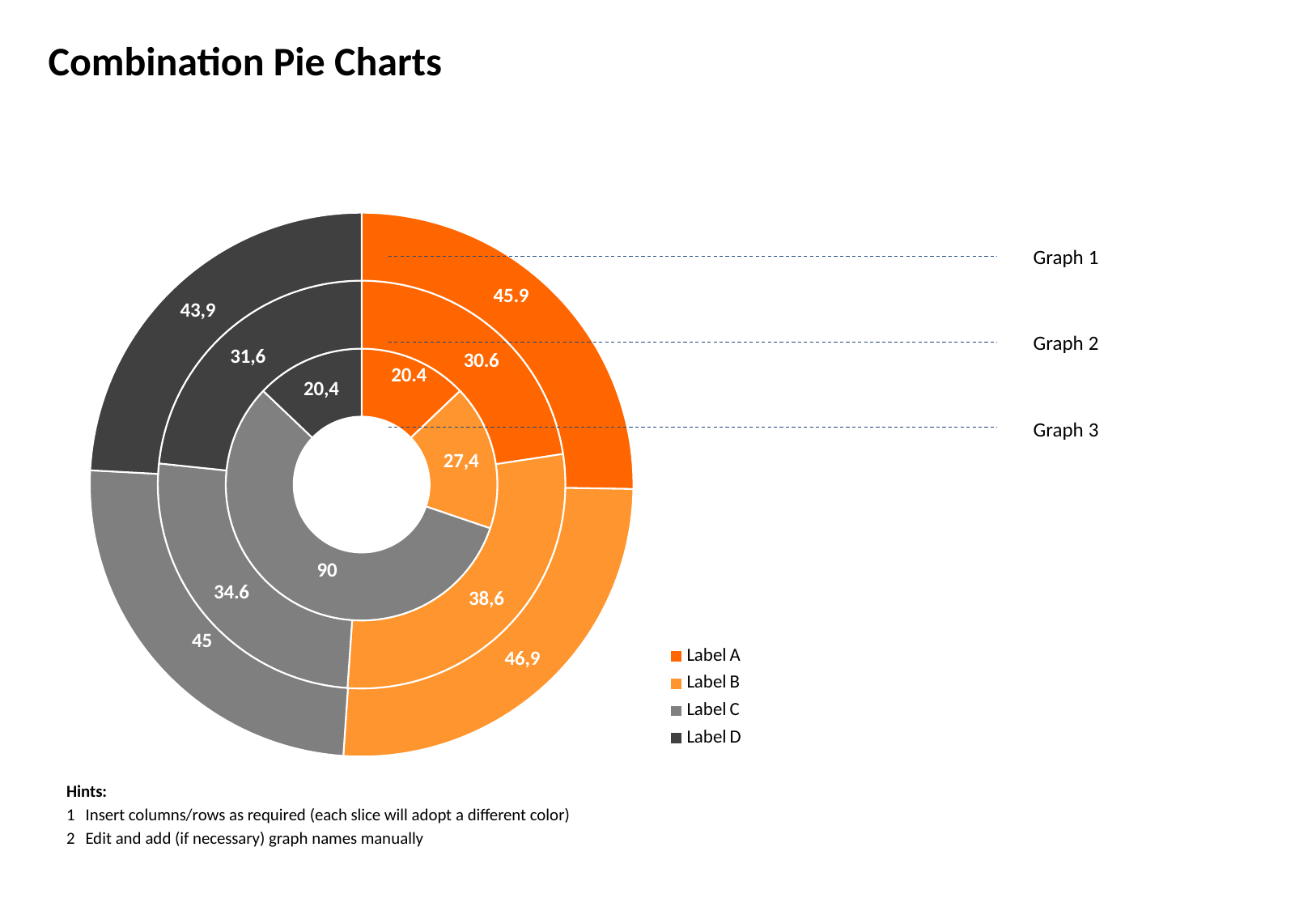
In the outer ring (Graph 1), what is the value for Label A? 45.9 In the outer ring (Graph 1), what is the difference between the values for Label B and Label D? 3 In the inner ring (Graph 3), what is the value for Label C? 90 In the middle ring (Graph 2), what is the value for Label C? 34.6 What kind of chart is shown on the slide? Doughnut chart In the outer ring (Graph 1), which label has the lowest value? Label D In the middle ring (Graph 2), what is the difference between the values for Label B and Label A? 8 How many entries does the legend list? 4 In the inner ring (Graph 3), what is the value for Label B? 27,4 In the outer ring (Graph 1), which label has the highest value? Label B In the inner ring (Graph 3), which label has the highest value? Label C In the middle ring (Graph 2), which label has the lowest value? Label A